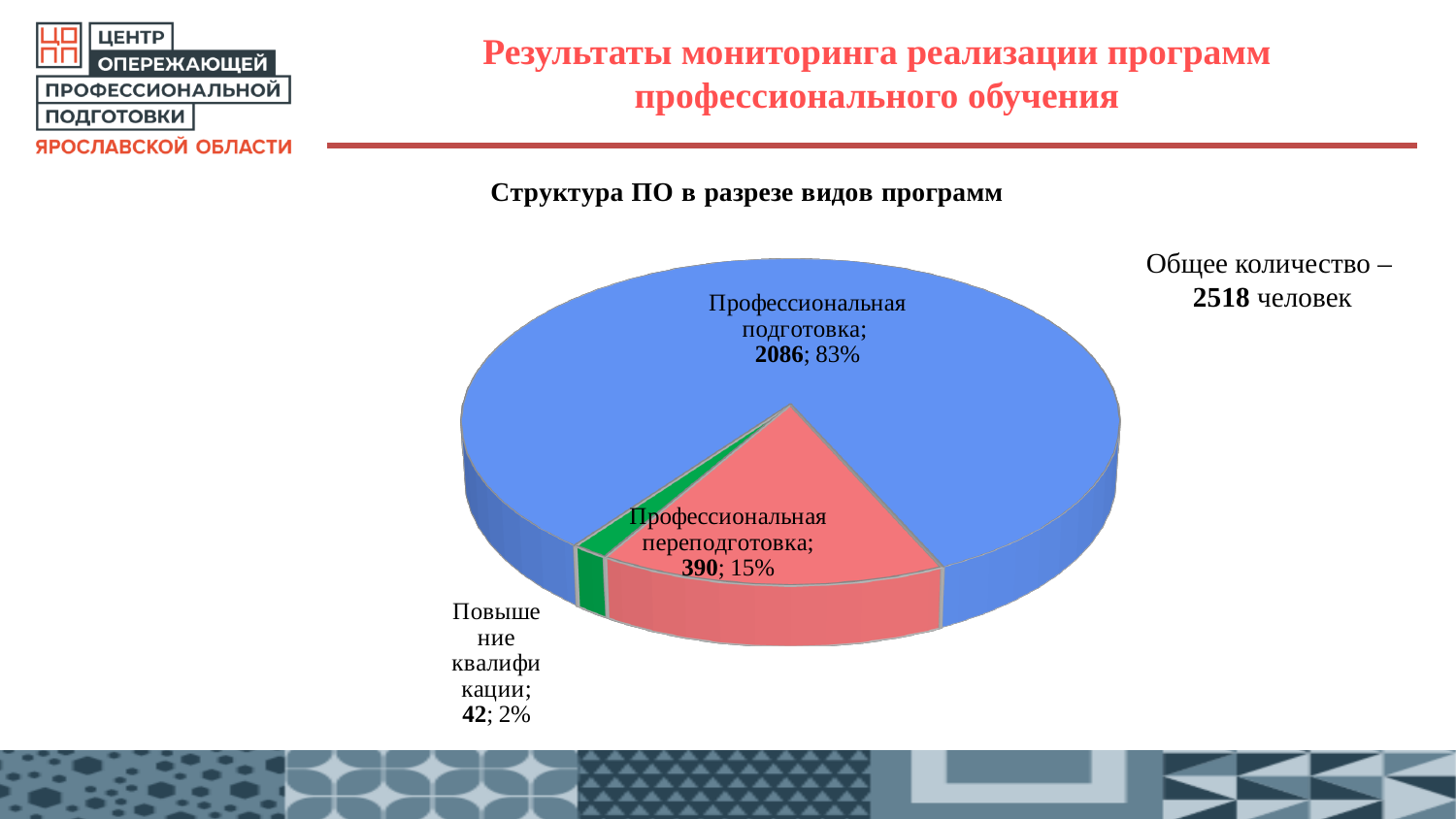
What is the difference between the values for Профессиональная подготовка and Профессиональная переподготовка? 1696 What is the value for Профессиональная переподготовка? 390 What kind of chart is shown on the slide? pie chart What share of the pie does Профессиональная подготовка represent? 83% What is the title of the chart? Структура ПО в разрезе видов программ How many slices does the pie chart have? 3 What share of the pie does Повышение квалификации represent? 2% Which category has the smallest slice? Повышение квалификации What is the value for Повышение квалификации? 42 What is the value for Профессиональная подготовка? 2086 Which category has the largest slice? Профессиональная подготовка Which is larger, the value for Профессиональная переподготовка or Повышение квалификации? Профессиональная переподготовка